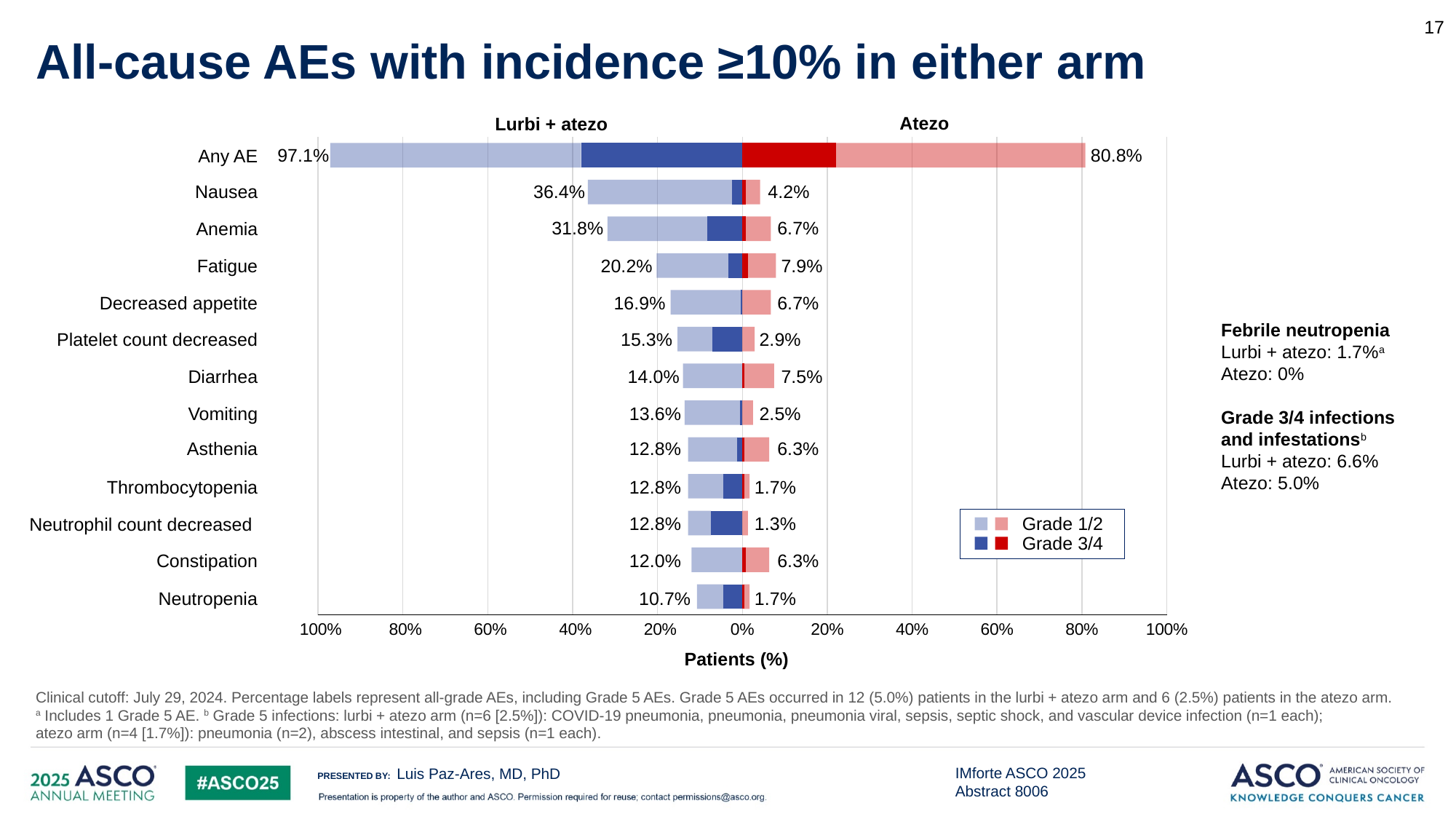
How many grade groups does the legend list? 2 In the Atezo arm, which has a higher incidence: Diarrhea or Vomiting? Diarrhea Which adverse event has the lowest incidence in the Lurbi + atezo arm? Neutropenia What is the all-cause AE incidence for Any AE in the Lurbi + atezo arm? 97.1% What is the difference in Any AE incidence between the Lurbi + atezo arm and the Atezo arm? 16.3 percentage points How many adverse event categories are plotted in the chart? 13 What is the incidence of Any AE in the Atezo arm? 80.8% Excluding the Any AE row, which adverse event has the highest incidence in the Lurbi + atezo arm? Nausea Excluding the Any AE row, which adverse event has the highest incidence in the Atezo arm? Fatigue What type of chart is shown on the slide? Bar chart What is the difference in Nausea incidence between the Lurbi + atezo arm and the Atezo arm? 32.2 percentage points What is the incidence of Fatigue in the Atezo arm? 7.9%